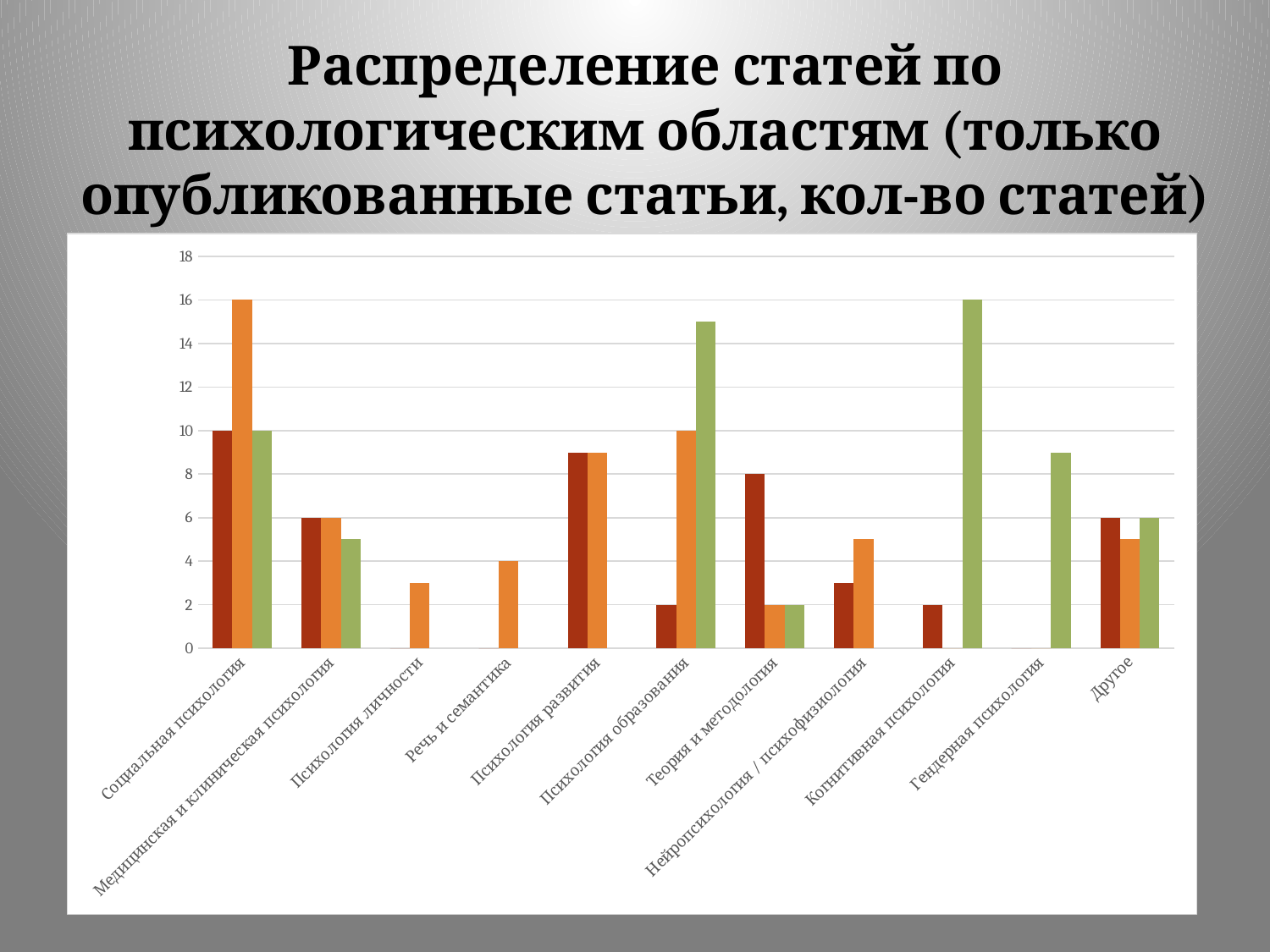
What is the value of the green bar for Когнитивная психология? 16 How many categories are shown along the x axis of the chart? 11 Which category has the tallest orange bar? Социальная психология What is the title of the slide? Распределение статей по психологическим областям (только опубликованные статьи, кол-во статей) Is the value of the green bar for Психология образования greater or less than 14? greater Which is larger: the green bar for Психология образования or the green bar for Гендерная психология? Психология образования What kind of chart is shown on the slide? bar chart What is the value of the orange bar for Социальная психология? 16 What is the value of the orange bar for Речь и семантика? 4 What is the value of the dark red bar for Теория и методология? 8 Which category has the tallest green bar? Когнитивная психология What is the difference between the orange bar for Социальная психология and the orange bar for Речь и семантика? 12